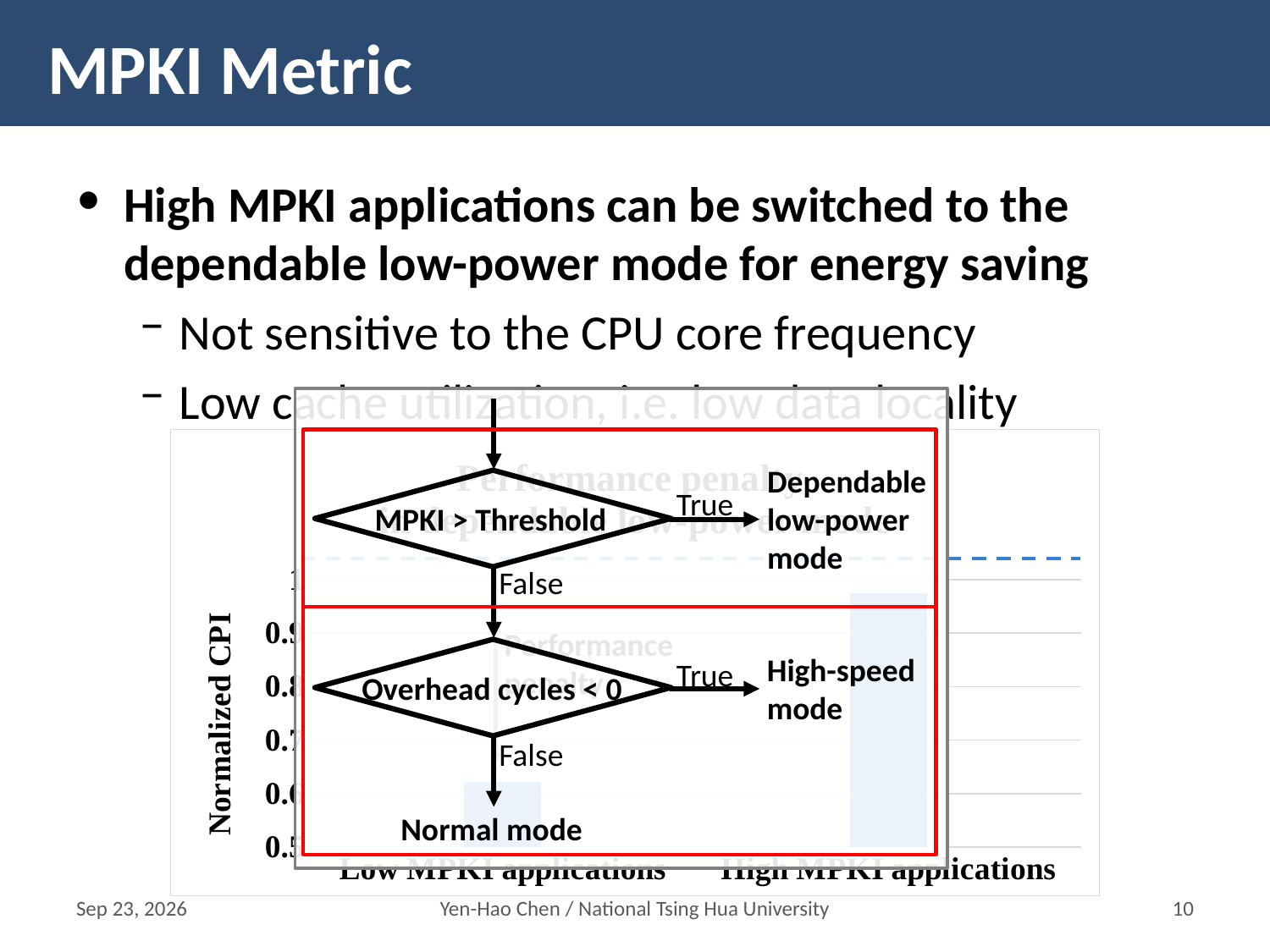
How many categories are shown on the x axis of the chart? 2 Which category has the higher Normalized CPI? High MPKI applications Is the Normalized CPI larger for Low MPKI applications or High MPKI applications? High MPKI applications What kind of chart is shown on the slide? bar chart Which category has the lower Normalized CPI? Low MPKI applications Does the Normalized CPI rise or fall from Low MPKI applications to High MPKI applications? rise Is the Normalized CPI for Low MPKI applications greater or less than 0.7? less Is the Normalized CPI for Low MPKI applications greater or less than 0.5? greater What is the label of the y axis of the chart? Normalized CPI Is the Normalized CPI for High MPKI applications greater or less than 0.9? greater